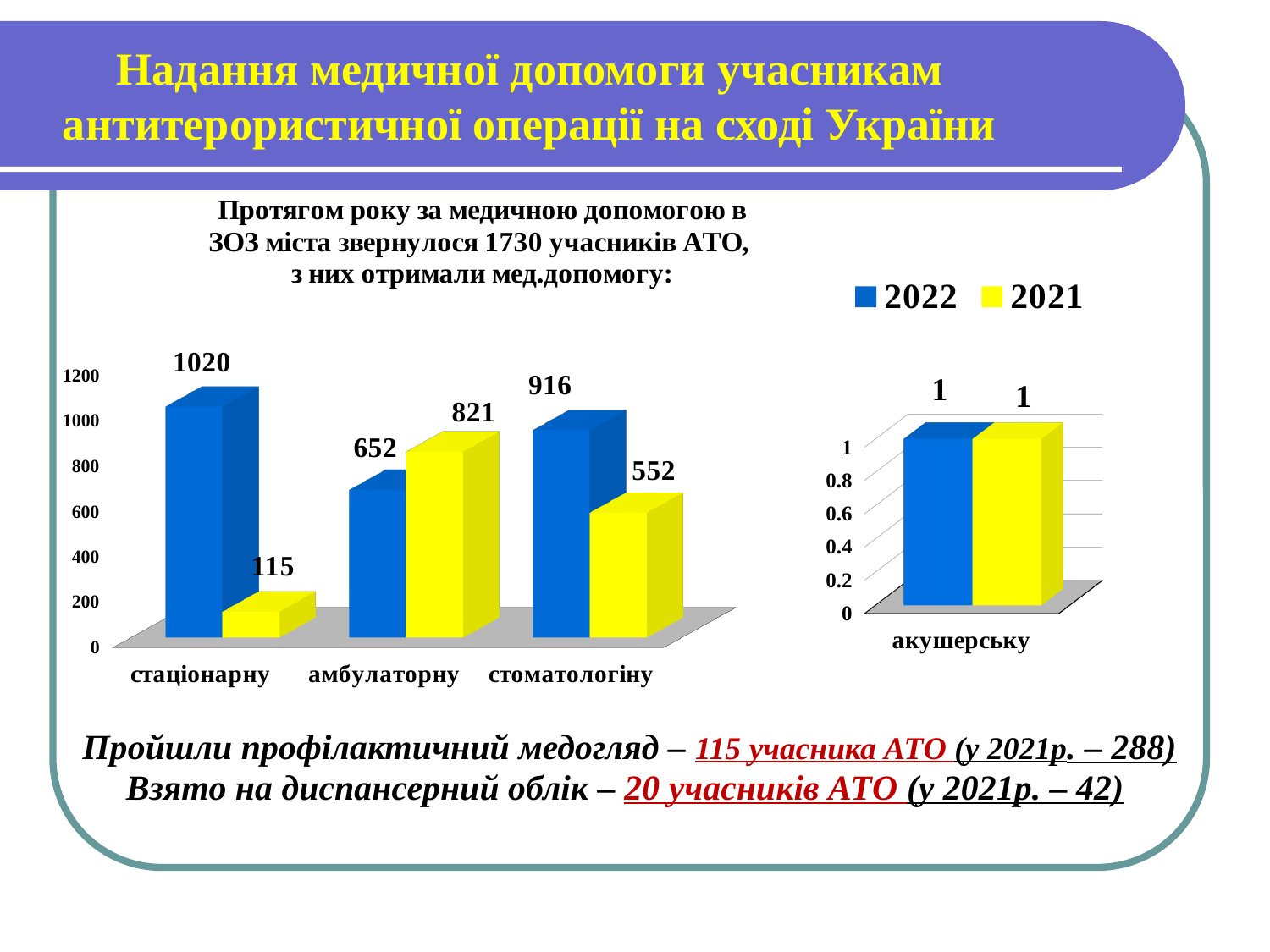
In the left chart, what is the 2022 value for стаціонарну? 1020 In the left chart, what is the 2021 value for стаціонарну? 115 In the left chart, which category has the highest 2022 value? стаціонарну In the left chart, for амбулаторну, which year has the larger value, 2022 or 2021? 2021 In the left chart, what is the 2021 value for амбулаторну? 821 In the right chart, what is the 2022 value for акушерську? 1 In the left chart, what is the 2021 value for стоматологіну? 552 What kind of chart is the left chart? bar chart In the left chart, what is the difference between the 2022 and 2021 values for стаціонарну? 905 How many series does the legend list? 2 In the left chart, how many categories are shown on the x axis? 3 In the left chart, which category has the lowest 2021 value? стаціонарну